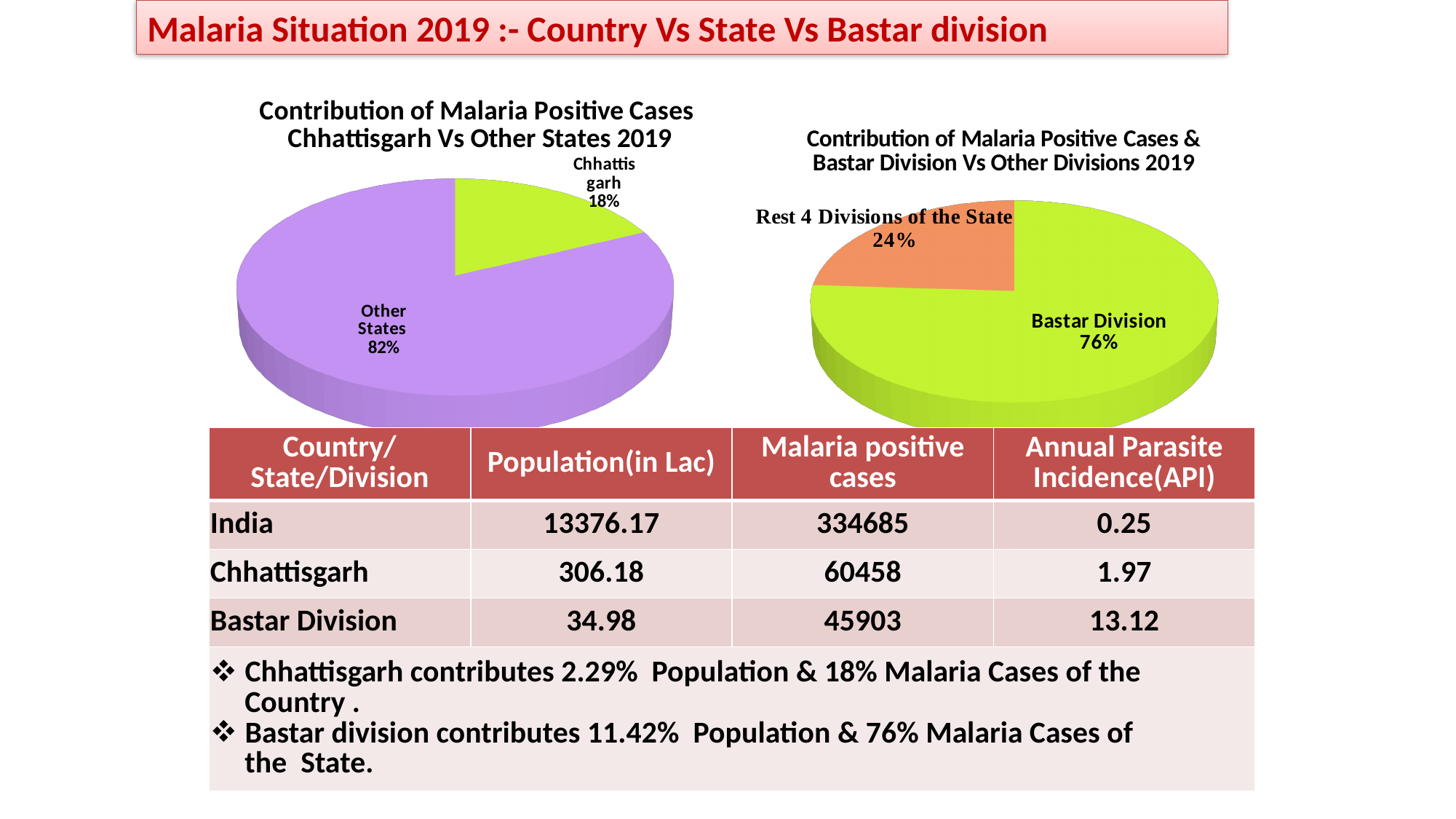
In the left pie chart (Chhattisgarh Vs Other States 2019), what share of malaria positive cases does Chhattisgarh contribute? 18% In the left pie chart (Chhattisgarh Vs Other States 2019), what is the difference in percentage points between the Other States slice and the Chhattisgarh slice? 64 Which is larger: the Chhattisgarh slice in the left pie chart or the Rest 4 Divisions slice in the right pie chart? Rest 4 Divisions of the State In the left pie chart (Chhattisgarh Vs Other States 2019), which slice is the largest? Other States In the right pie chart (Bastar Division Vs Other Divisions 2019), what colour is the Bastar Division slice? Green How many slices does the right pie chart (Bastar Division Vs Other Divisions 2019) have? 2 In the right pie chart (Bastar Division Vs Other Divisions 2019), what share is attributed to the Rest 4 Divisions of the State? 24% In the left pie chart (Chhattisgarh Vs Other States 2019), what share of malaria positive cases do Other States contribute? 82% What type of chart is the left chart (Chhattisgarh Vs Other States 2019)? Pie chart In the right pie chart (Bastar Division Vs Other Divisions 2019), what is the difference in percentage points between the Bastar Division slice and the Rest 4 Divisions slice? 52 In the right pie chart (Bastar Division Vs Other Divisions 2019), what share of malaria positive cases does Bastar Division contribute? 76% In the right pie chart (Bastar Division Vs Other Divisions 2019), which slice is the smallest? Rest 4 Divisions of the State